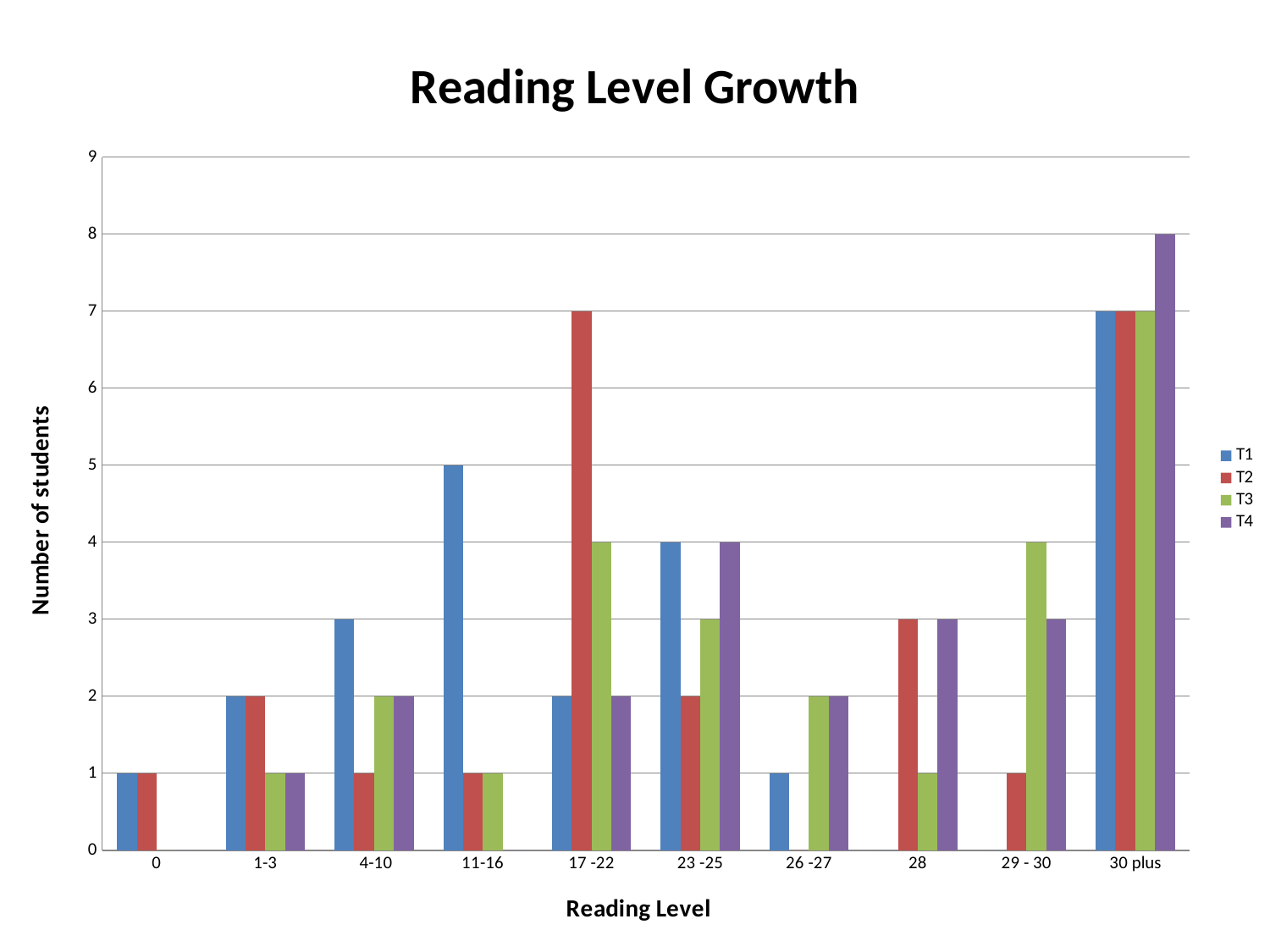
What is the number of students for T4 at reading level 30 plus? 8 What is the difference between T2 and T1 at reading level 17 -22? 5 How many series does the legend list? 4 What is the number of students for T1 at reading level 11-16? 5 What is the label on the vertical axis? Number of students Which reading level has the highest number of students for T4? 30 plus Is the value for T4 at reading level 30 plus greater or less than 5? greater At reading level 4-10, which is larger, T1 or T3? T1 What is the number of students for T2 at reading level 17 -22? 7 What kind of chart is shown on the slide? bar chart How many reading level categories are shown on the x axis? 10 What is the title of the chart? Reading Level Growth